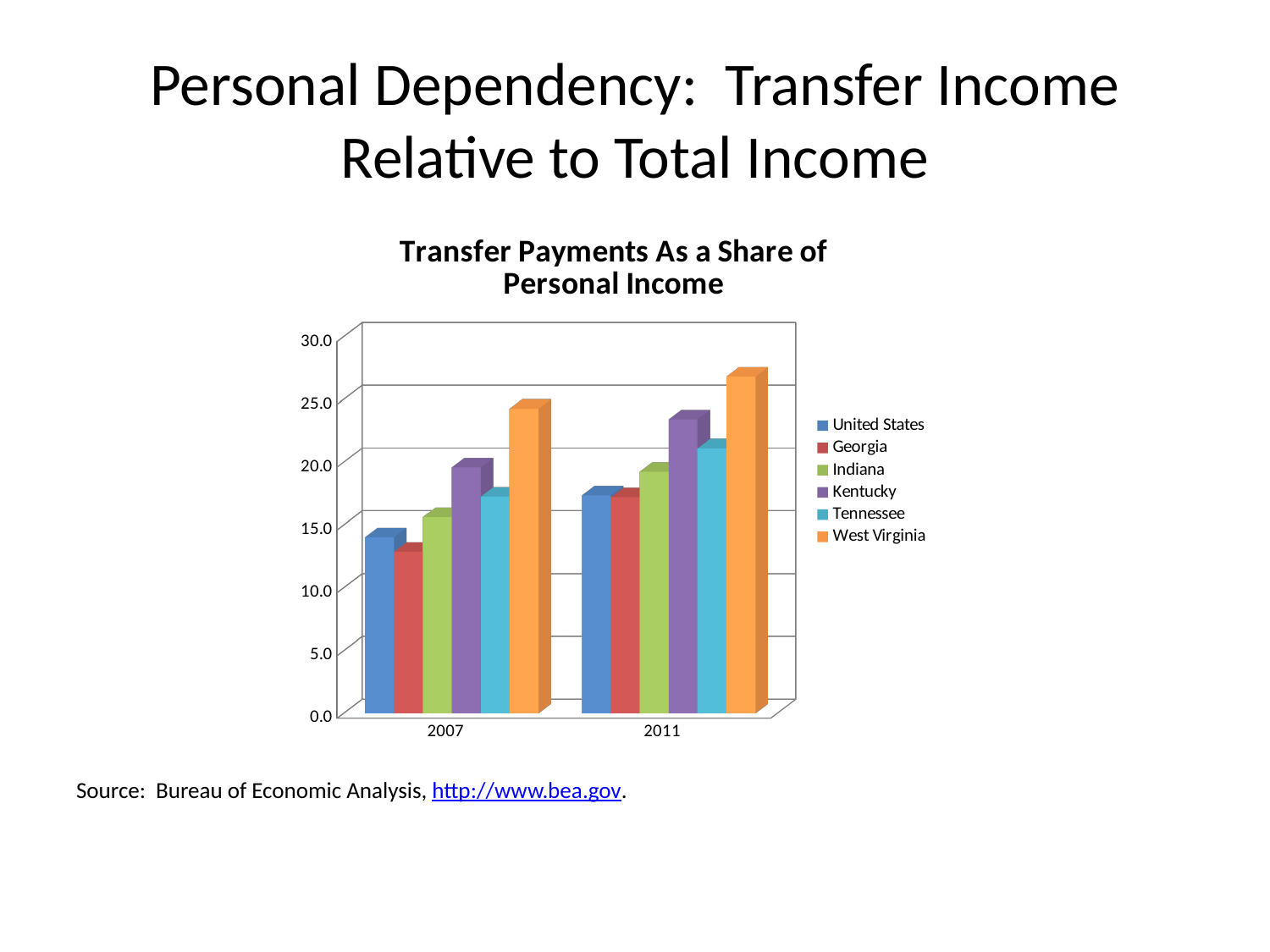
How many year categories are shown on the x axis? 2 How many series does the legend list? 6 Which series has the highest value in 2007? West Virginia In 2007, which is larger: the value for Kentucky or the value for Tennessee? Kentucky Which series has the highest value in 2011? West Virginia Which series has the lowest value in 2007? Georgia Does the value for Kentucky rise or fall from 2007 to 2011? Rise Is the value for Georgia in 2007 greater or less than 15.0? less Is the value for West Virginia in 2011 greater or less than 25.0? greater What is the title of the chart? Transfer Payments As a Share of Personal Income Is the value for West Virginia in 2007 greater or less than 20.0? greater What kind of chart is shown on the slide? Bar chart